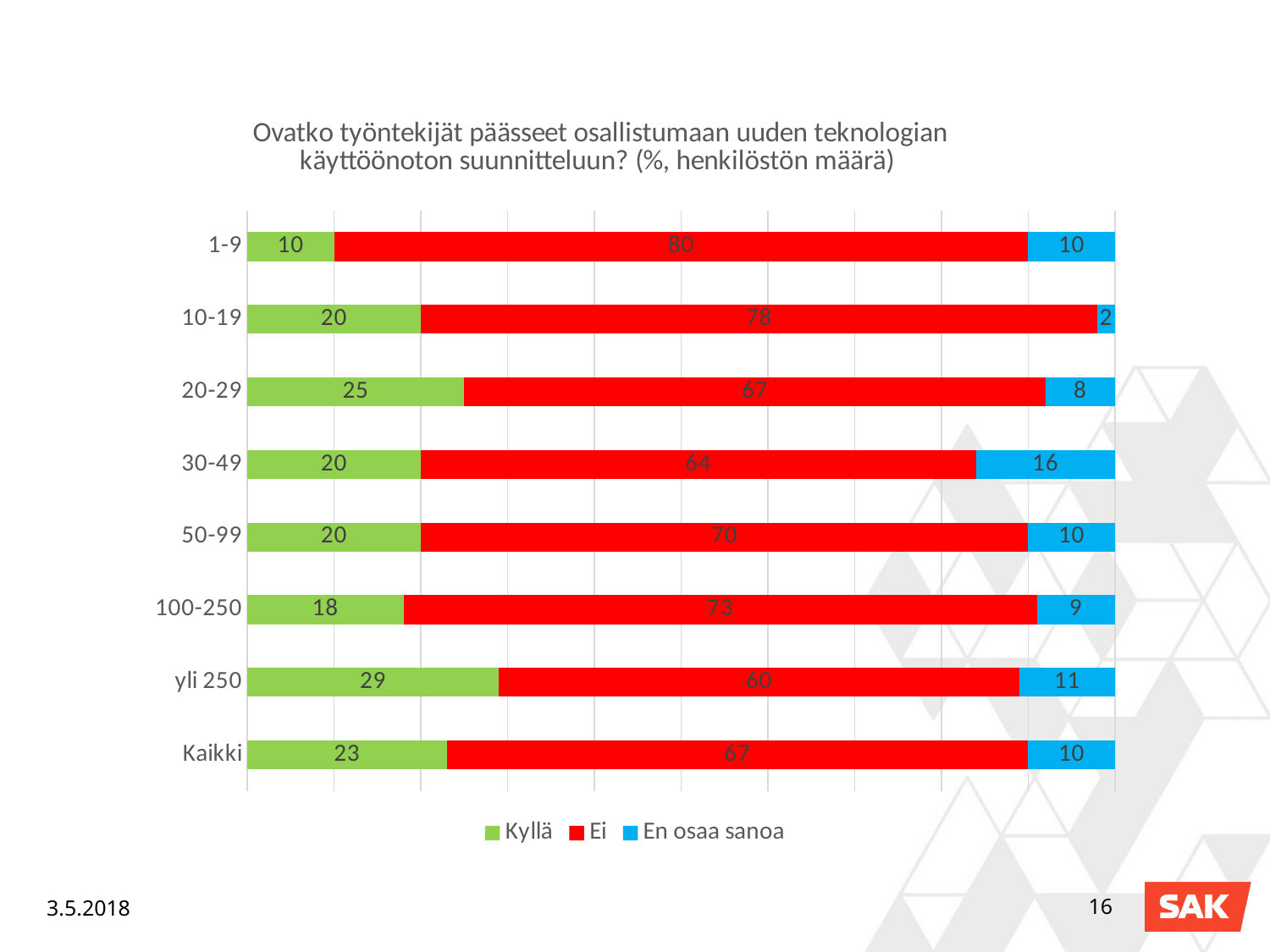
What is the Ei value for the Kaikki category? 67 What is the difference between the Ei values for 1-9 and yli 250? 20 Which category has the highest Kyllä value? yli 250 Which is larger, the Kyllä value for 20-29 or the Kyllä value for 100-250? 20-29 Which category has the lowest En osaa sanoa value? 10-19 How many series does the legend list? 3 What kind of chart is shown on the slide? Stacked bar chart Which category has the highest Ei value? 1-9 What is the En osaa sanoa value for the 30-49 category? 16 What is the Ei value for the yli 250 category? 60 How many categories are shown on the y axis? 8 What is the Kyllä value for the 1-9 category? 10